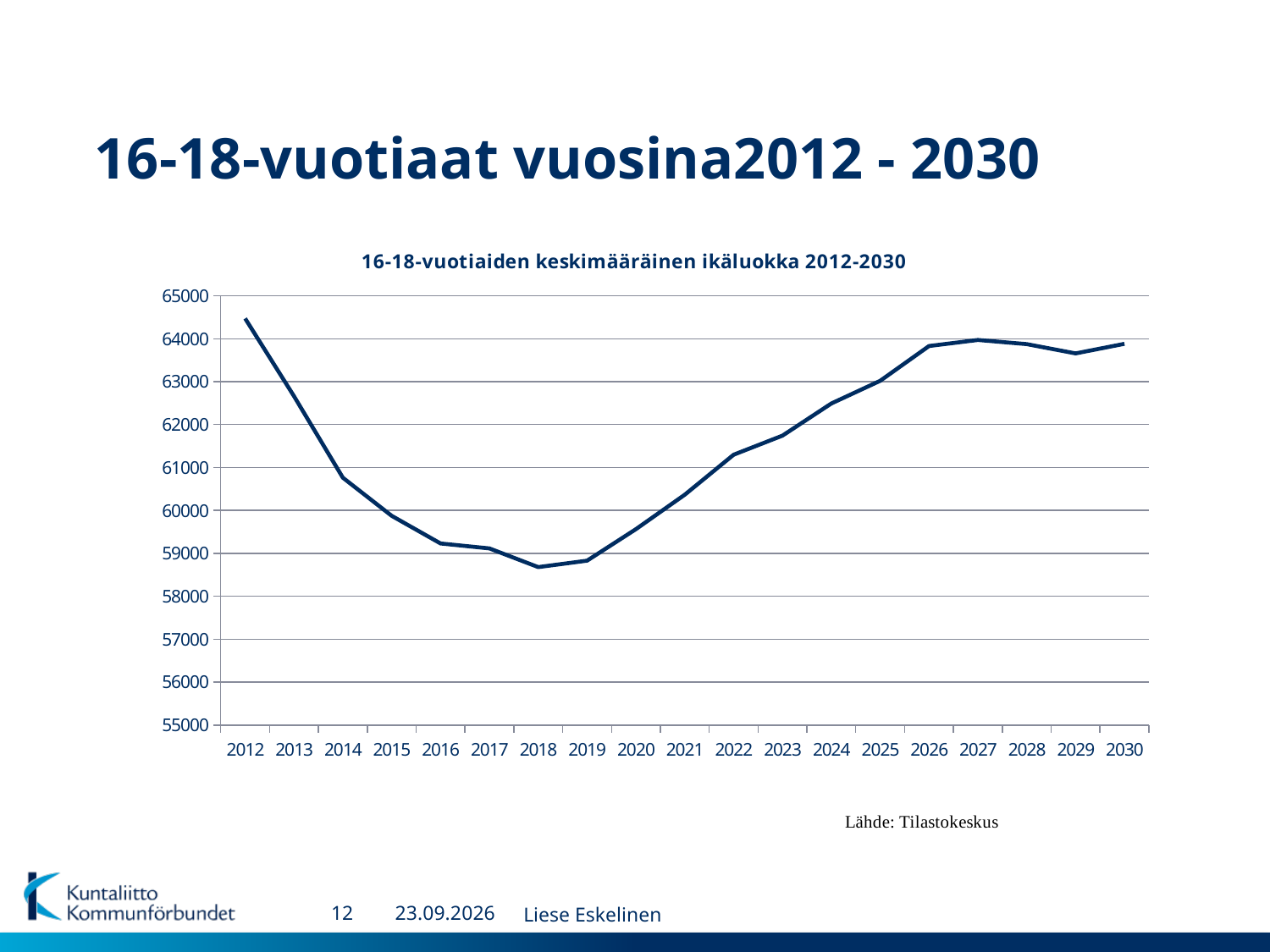
In which year is the plotted value the lowest? 2018 In which year is the plotted value the highest? 2012 How many years are plotted along the x axis of the chart? 19 Is the value for 2018 greater or less than 59000? less Is the value for 2016 greater or less than 60000? less Do the values rise or fall from 2012 to 2018? fall Is the value for 2014 greater or less than 61000? less Which year has the larger value, 2013 or 2022? 2013 What is the title of the chart? 16-18-vuotiaiden keskimääräinen ikäluokka 2012-2030 What kind of chart is shown on the slide? line chart